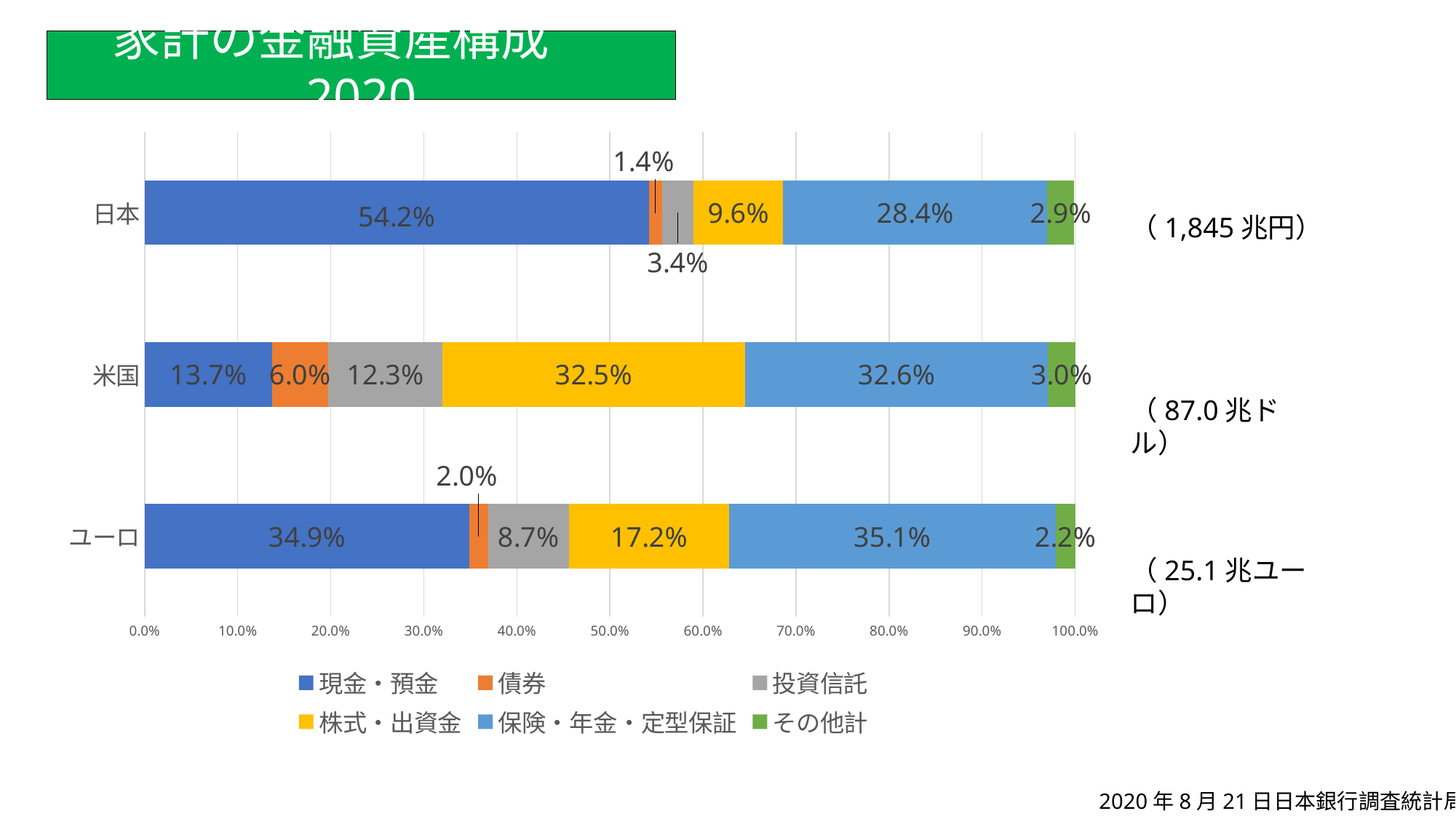
What is the value for 保険・年金・定型保証 for ユーロ? 35.1% What is the difference between the 現金・預金 values for 日本 and 米国? 40.5% Which is larger, the 投資信託 value for 米国 or for ユーロ? 米国 What is the value for 株式・出資金 for 米国? 32.5% Which category has the lowest value for 株式・出資金? 日本 What is the value for 債券 for 日本? 1.4% What kind of chart is shown on the slide? Stacked bar chart How many categories are shown on the y axis? 3 What is the value for 現金・預金 for 日本? 54.2% Which colour represents 株式・出資金 in the chart? Yellow How many series does the legend list? 6 Which category has the highest value for 現金・預金? 日本